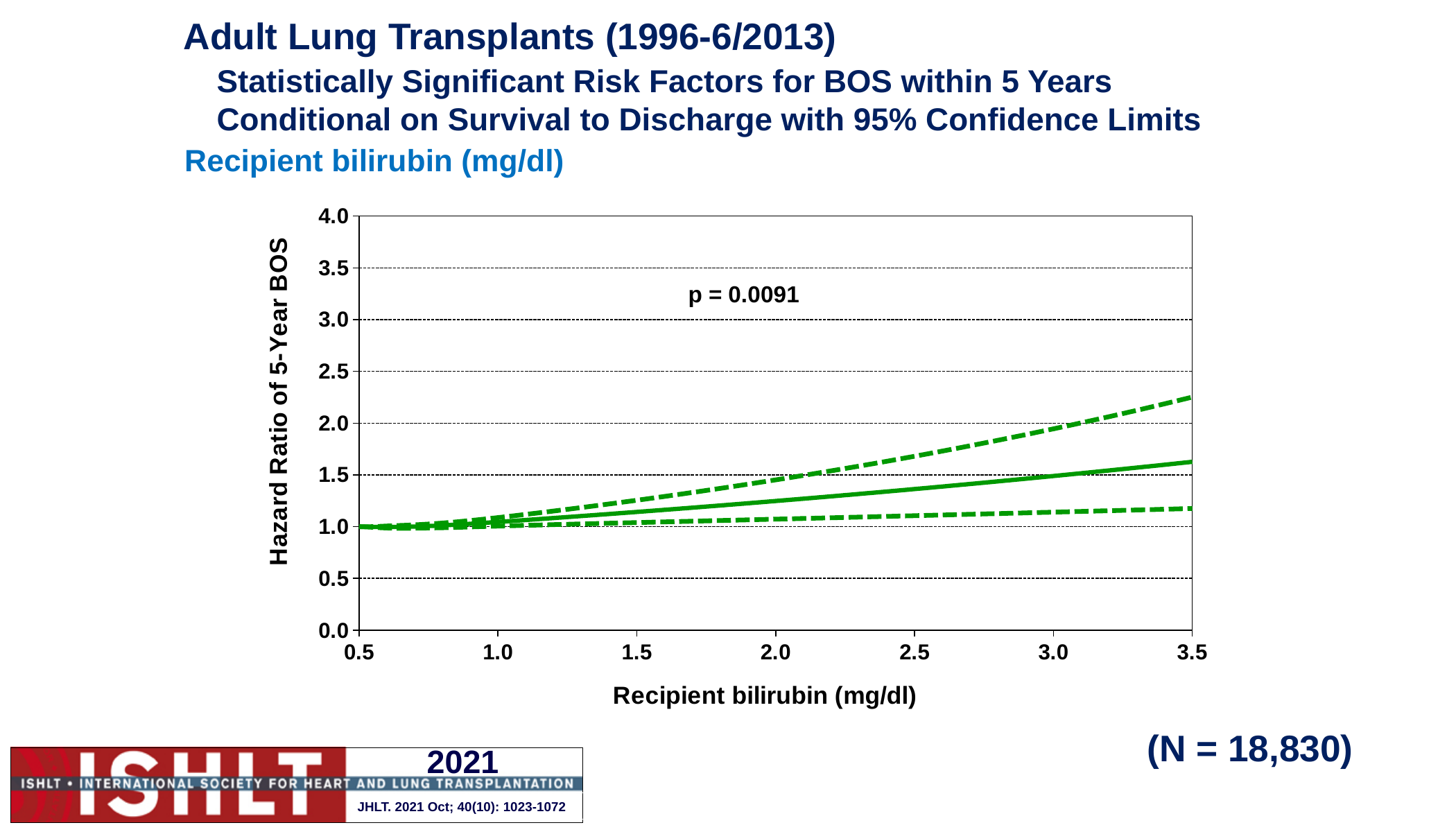
What is the label of the y axis? Hazard Ratio of 5-Year BOS What is the hazard ratio of the solid line at a recipient bilirubin of 0.5 mg/dl? 1.0 What is the sample size (N) shown on the slide? 18,830 What kind of chart is shown on the slide? line chart What is the label of the x axis? Recipient bilirubin (mg/dl) Does the hazard ratio of 5-year BOS rise or fall as recipient bilirubin increases from 0.5 to 3.5 mg/dl? rise Is the upper confidence limit (upper dashed line) at a recipient bilirubin of 3.5 mg/dl greater or less than 2.0? greater Is the lower confidence limit (lower dashed line) at a recipient bilirubin of 3.5 mg/dl greater or less than 1.5? less Is the hazard ratio of the solid line at a recipient bilirubin of 2.0 mg/dl greater or less than 1.5? less How many lines are plotted on the chart? 3 What is the p-value printed on the chart? p = 0.0091